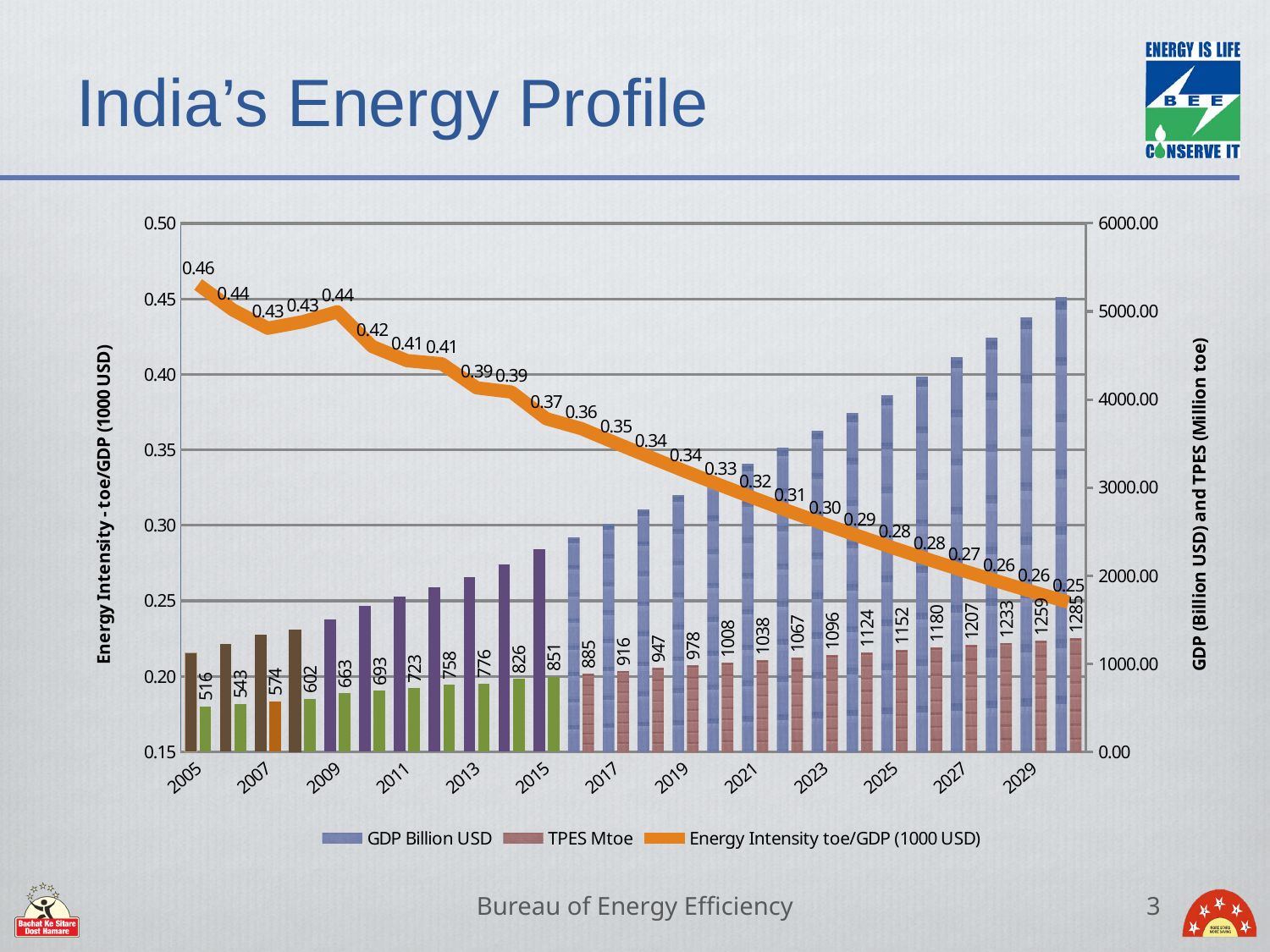
What is the Energy Intensity value for 2005? 0.46 Which is larger, the TPES Mtoe value for 2015 or for 2017? 2017 Is the GDP Billion USD bar for 2029 greater or less than 4000.00? greater What is the TPES Mtoe value for 2029? 1259 How many series does the legend list? 3 In which year is the Energy Intensity highest? 2005 What is the Energy Intensity value for 2015? 0.37 What is the difference between the Energy Intensity values for 2005 and 2029? 0.20 What kind of chart is shown on the slide? Combination bar and line chart What is the TPES Mtoe value for 2005? 516 Does the Energy Intensity line rise or fall from 2005 to 2029? Fall What is the title of the right-hand vertical axis? GDP (Billion USD) and TPES (Million toe)